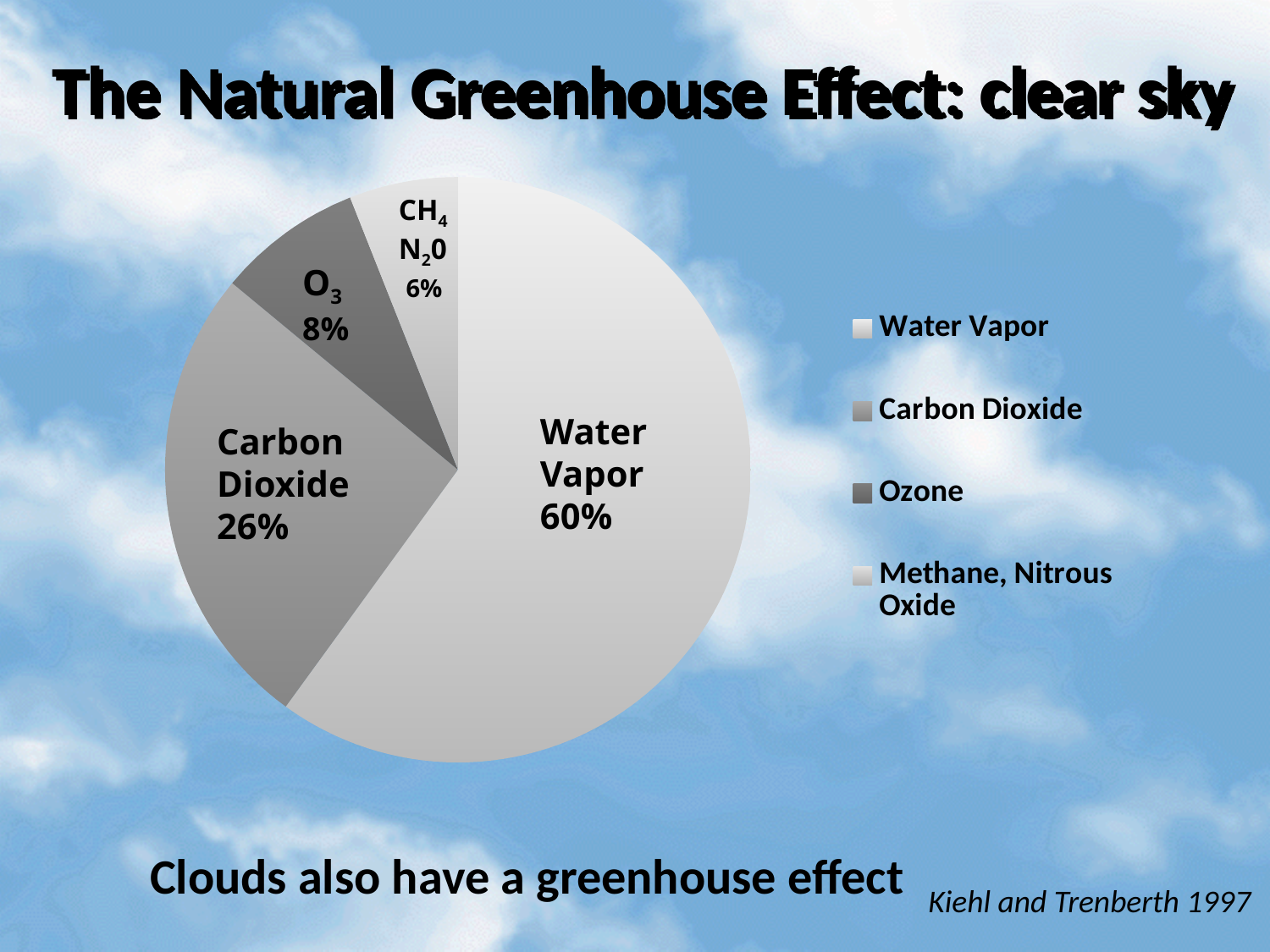
Which slice of the pie is the smallest? Methane, Nitrous Oxide What is the title of the slide containing the pie chart? The Natural Greenhouse Effect: clear sky What share of the pie do Methane and Nitrous Oxide (CH4, N2O) account for? 6% How many entries does the legend list? 4 Which is larger, the Ozone slice or the Methane, Nitrous Oxide slice? Ozone What share of the pie does Carbon Dioxide account for? 26% What is the difference in percentage points between the Water Vapor slice and the Carbon Dioxide slice? 34 What type of chart is shown on the slide? Pie chart Which slice of the pie is the largest? Water Vapor How many slices does the pie chart have? 4 What share of the pie does Ozone (O3) account for? 8%